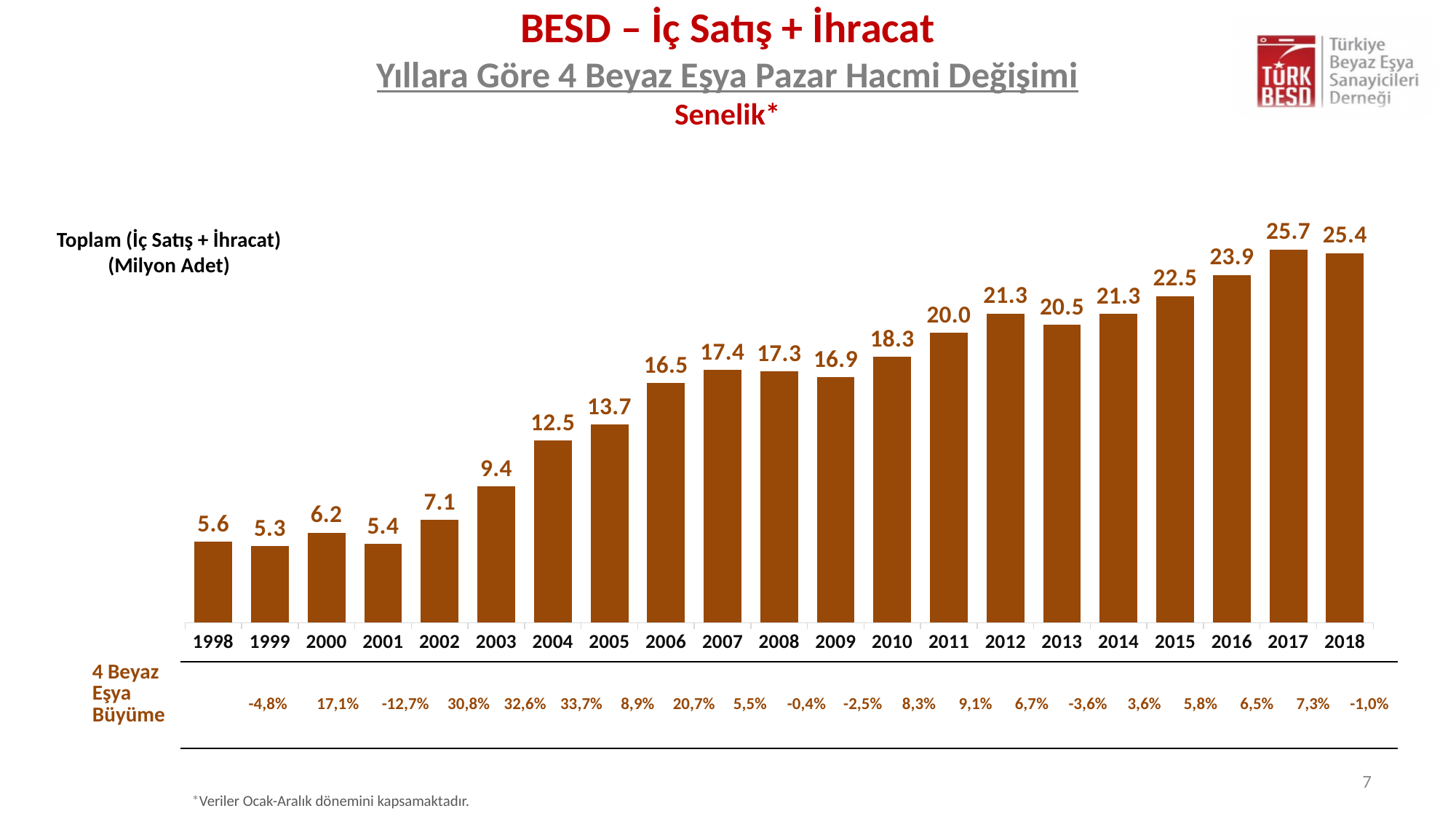
What kind of chart is shown on the slide? bar chart Do the total values generally rise or fall from 1998 to 2018? rise How many years are shown on the x axis of the chart? 21 What unit is given for the total (İç Satış + İhracat) values on the chart? Milyon Adet What is the 4 Beyaz Eşya Büyüme (growth) percentage shown for 2005? 8,9% Which year has the lowest total (İç Satış + İhracat) value? 1999 What is the difference between the total values for 2004 and 2003? 3.1 What is the total (İç Satış + İhracat) value for 2010? 18.3 Which year has the highest total (İç Satış + İhracat) value? 2017 What is the difference between the total values for 2017 and 2018? 0.3 Which year has a larger total value, 2012 or 2013? 2012 What is the total (İç Satış + İhracat) value for 1998? 5.6